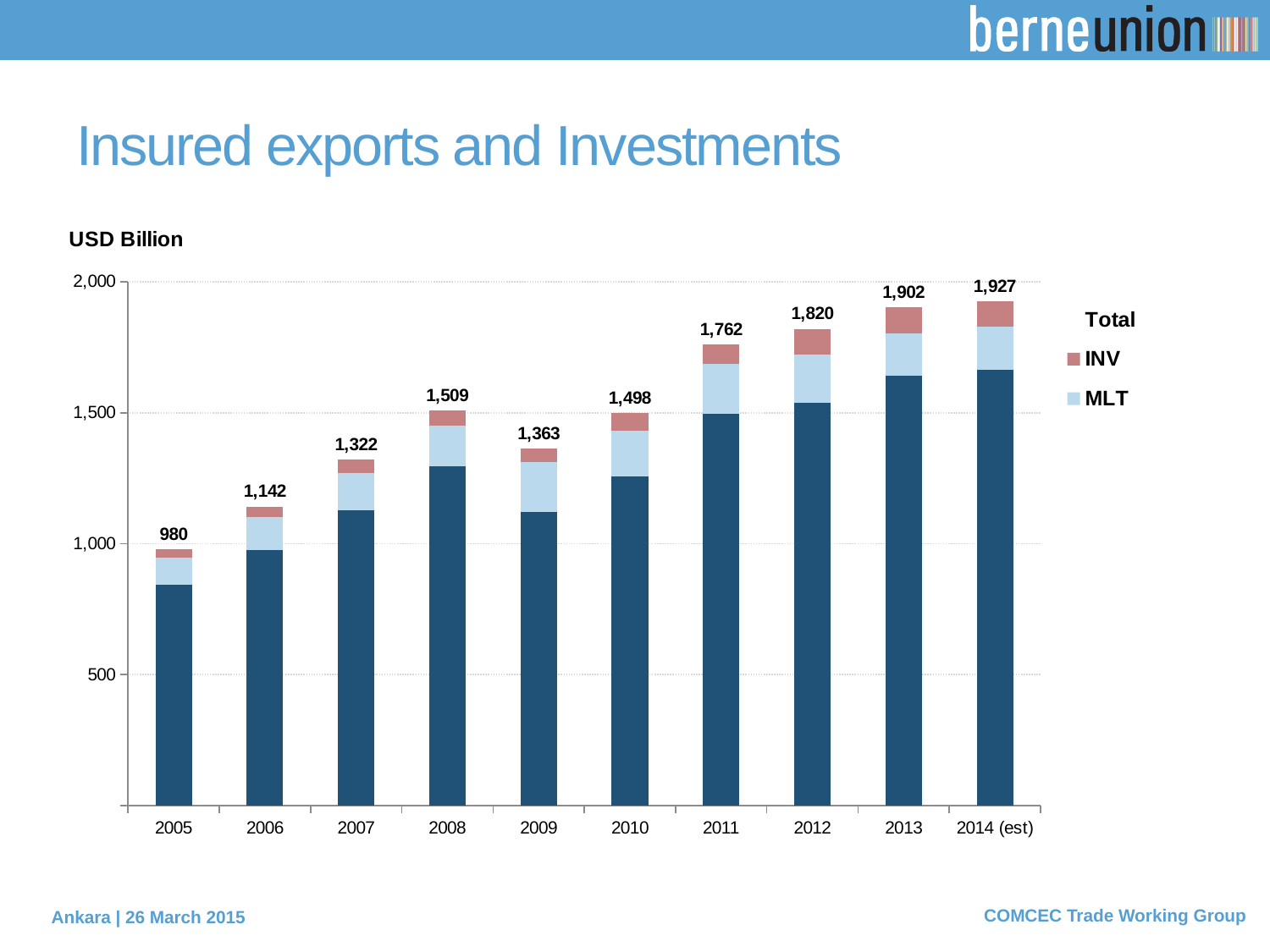
What is the total value shown for 2014 (est)? 1,927 What is the total value shown for 2009? 1,363 What unit is the chart's y axis measured in, according to the label above the chart? USD Billion What kind of chart is shown on the slide? Stacked bar chart By how much does the 2014 (est) total exceed the 2005 total? 947 How many years are shown on the x axis? 10 What is the difference between the 2008 total and the 2009 total? 146 Which year has the larger total, 2008 or 2010? 2008 Which year has the highest total? 2014 (est) Which year has the lowest total? 2005 What is the total insured exports and investments value for 2008? 1,509 How many entries does the legend list? 3